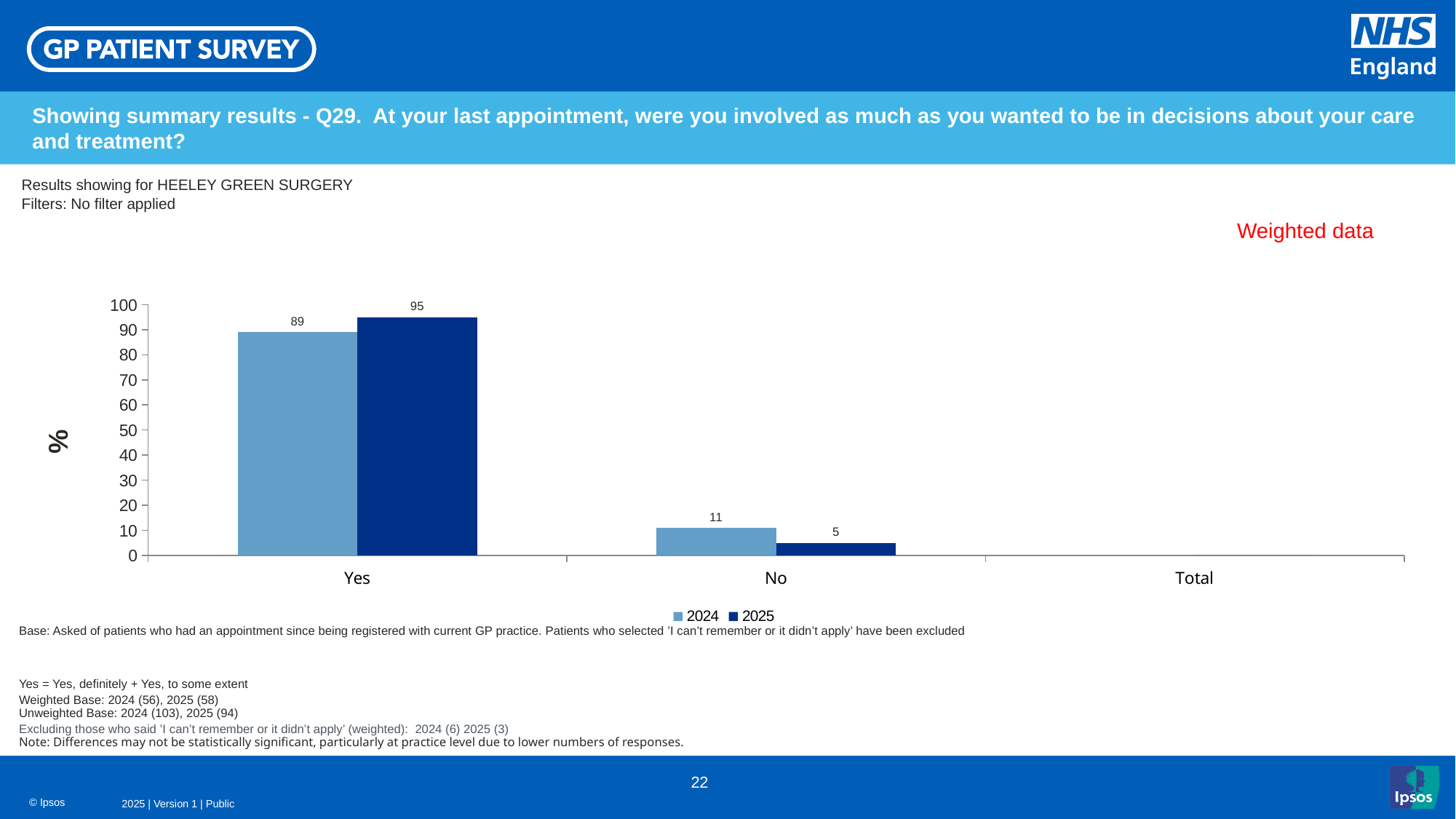
What kind of chart is shown on the slide? Bar chart Which is larger in the No category, the 2024 value or the 2025 value? 2024 What is the value for 2025 in the Yes category? 95 What is the value for 2025 in the No category? 5 What label is shown on the vertical axis of the chart? % What is the value for 2024 in the Yes category? 89 What is the difference between the 2024 and 2025 values in the No category? 6 What is the value for 2024 in the No category? 11 How many series does the legend list? 2 Which category has the lowest value for the 2024 series? No Which category has the highest value for the 2025 series? Yes What is the difference between the 2025 and 2024 values in the Yes category? 6